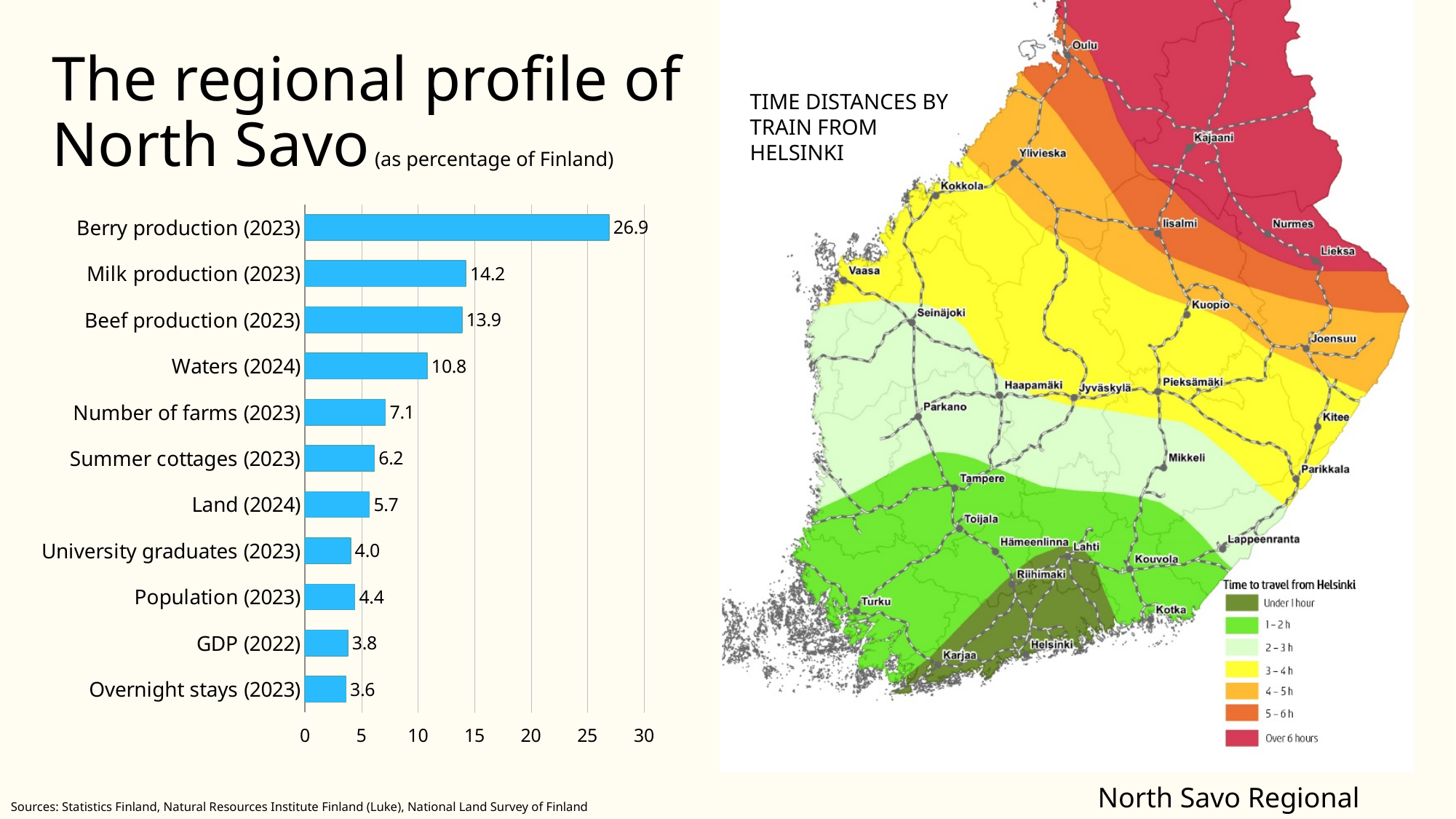
Which is larger in the bar chart: Population (2023) or University graduates (2023)? Population (2023) What is the value for Berry production (2023) in the bar chart? 26.9 What is the title of the chart on the left of the slide? The regional profile of North Savo (as percentage of Finland) What is the value for Waters (2024) in the bar chart? 10.8 What is the difference between Berry production (2023) and Overnight stays (2023) in the bar chart? 23.3 What is the value for GDP (2022) in the bar chart? 3.8 How many categories are shown in the bar chart? 11 What is the difference between Milk production (2023) and Beef production (2023) in the bar chart? 0.3 What kind of chart is shown on the left of the slide? bar chart Is the value for Number of farms (2023) greater or less than 5? greater Which category has the highest value in the bar chart? Berry production (2023) Which category has the lowest value in the bar chart? Overnight stays (2023)